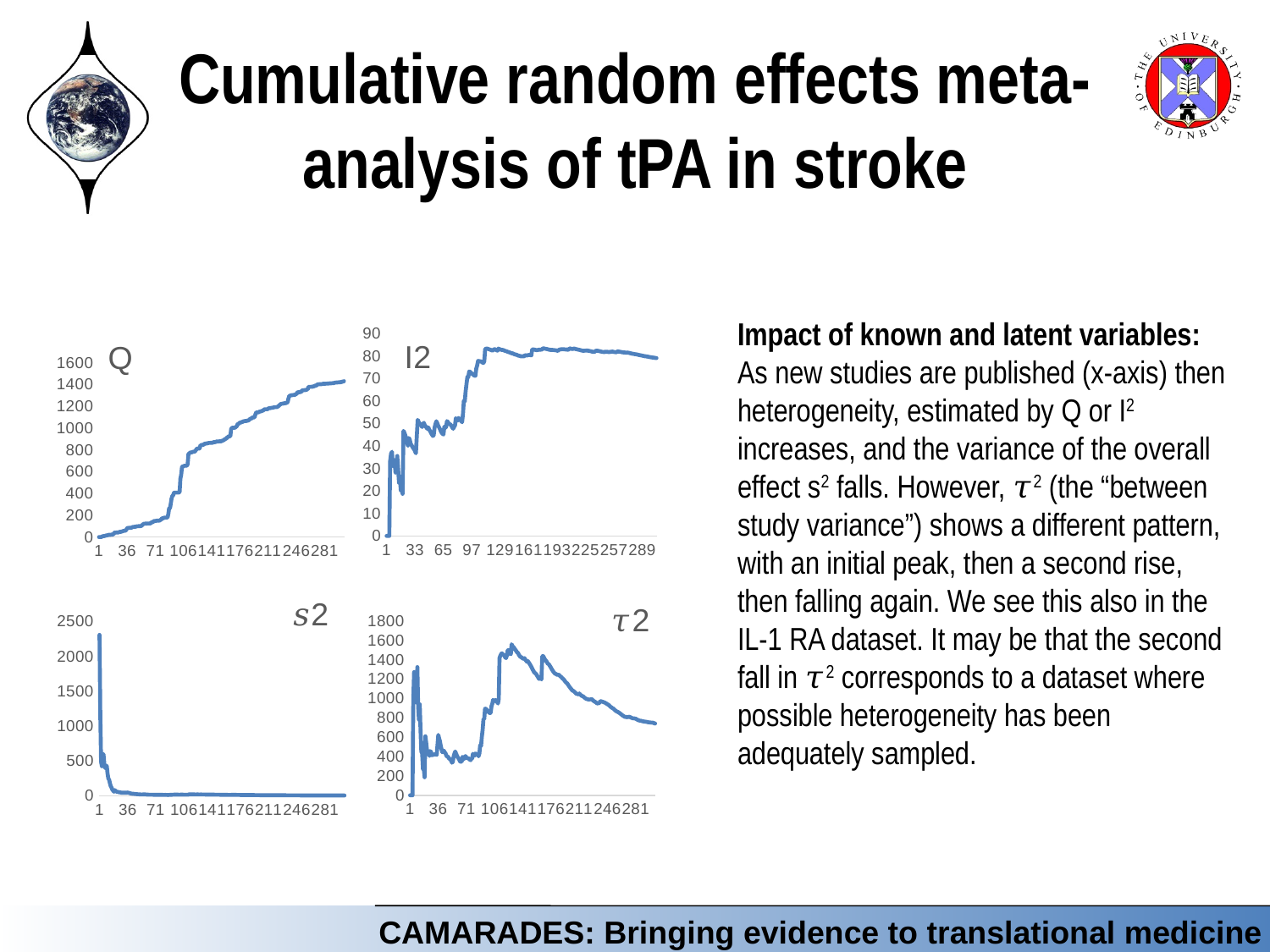
In the chart titled Q, is the final value at the right end of the line greater or less than 1200? greater In the chart titled s2, is the final value at the right end of the line greater or less than 500? less In the chart titled τ2, is the final value at the right end of the line greater or less than 1000? less In the chart titled s2, do the values rise or fall along the x axis? fall In the chart titled I2, do the values overall rise or fall along the x axis? rise What is the title of the chart in the bottom-left position on the slide? s2 What kind of chart is the chart titled Q? line chart In the chart titled Q, do the values rise or fall along the x axis? rise How many charts are shown on the slide? 4